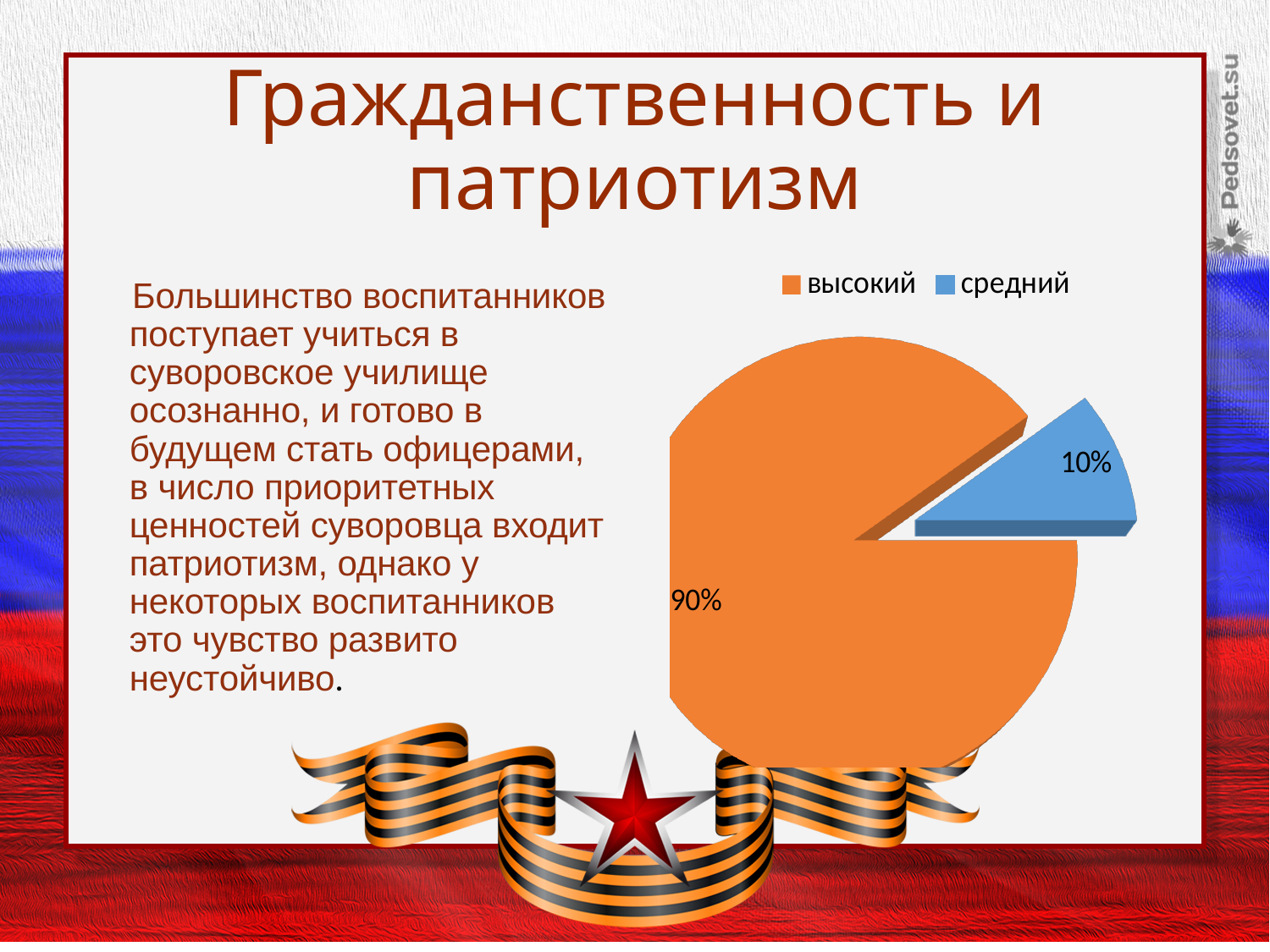
How many slices does the pie chart have? 2 Which is larger, the value for высокий or the value for средний? высокий What is the difference between the values for высокий and средний? 80% What is the value for средний? 10% What share of the pie does the средний slice represent? 10% How many entries does the legend list? 2 What colour is the slice for средний? blue Which category has the smallest slice? средний Which category has the largest slice? высокий What kind of chart is shown on the slide? pie chart What is the value for высокий? 90% What colour is the slice for высокий? orange